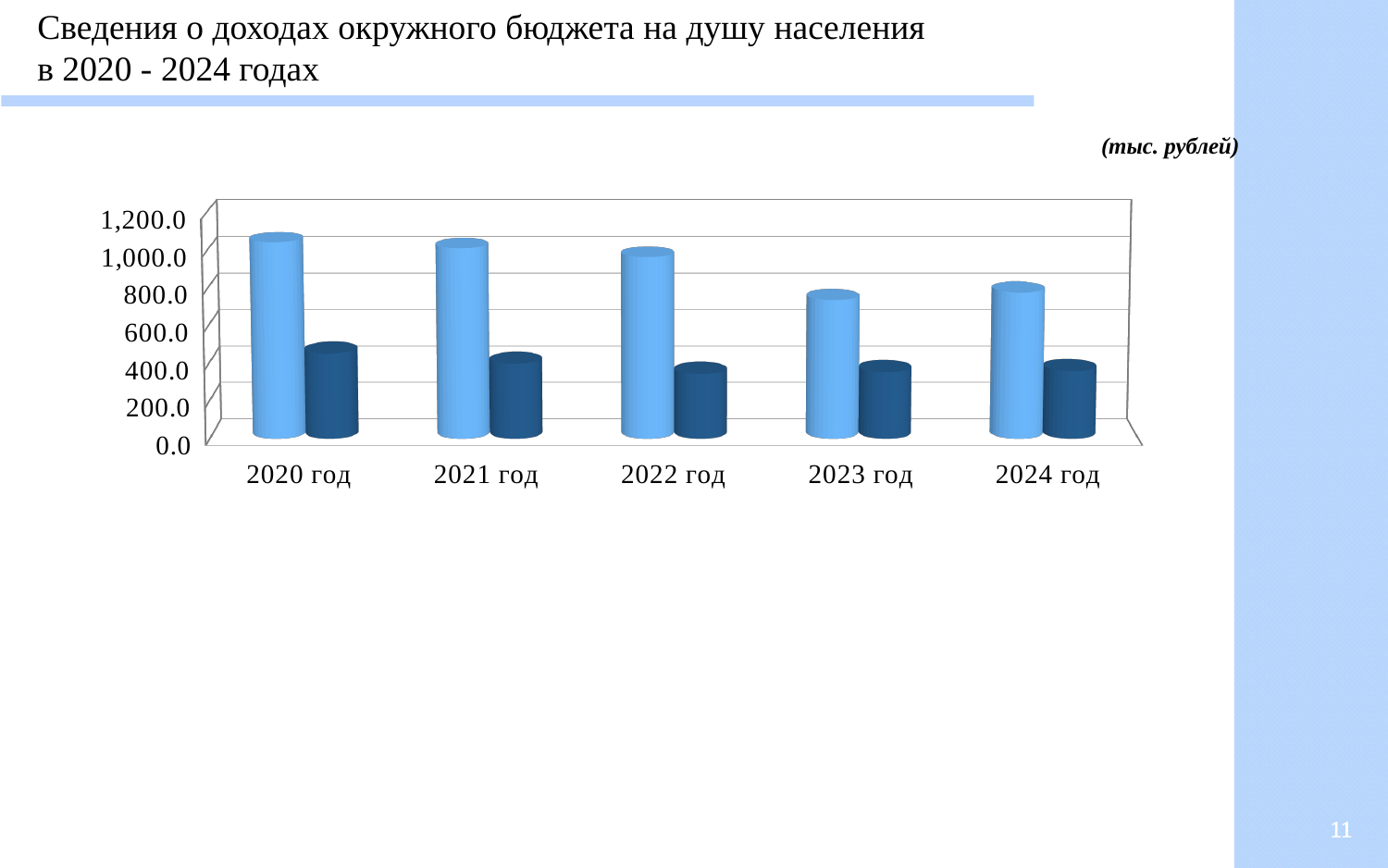
Is the value of the dark blue bar for 2020 год greater or less than 200.0? greater Is the value of the light blue bar for 2023 год greater or less than 1,000.0? less Which is larger, the light blue bar for 2020 год or the light blue bar for 2023 год? 2020 год Do the light blue bars overall rise or fall from 2020 год to 2024 год? fall How many year categories are shown on the x axis of the chart? 5 Is the value of the light blue bar for 2020 год greater or less than 1,000.0? greater What kind of chart is shown on the slide? bar chart How many data series are plotted in the chart? 2 What unit of measurement is indicated above the chart? тыс. рублей In 2020 год, which bar is taller, the light blue one or the dark blue one? the light blue one